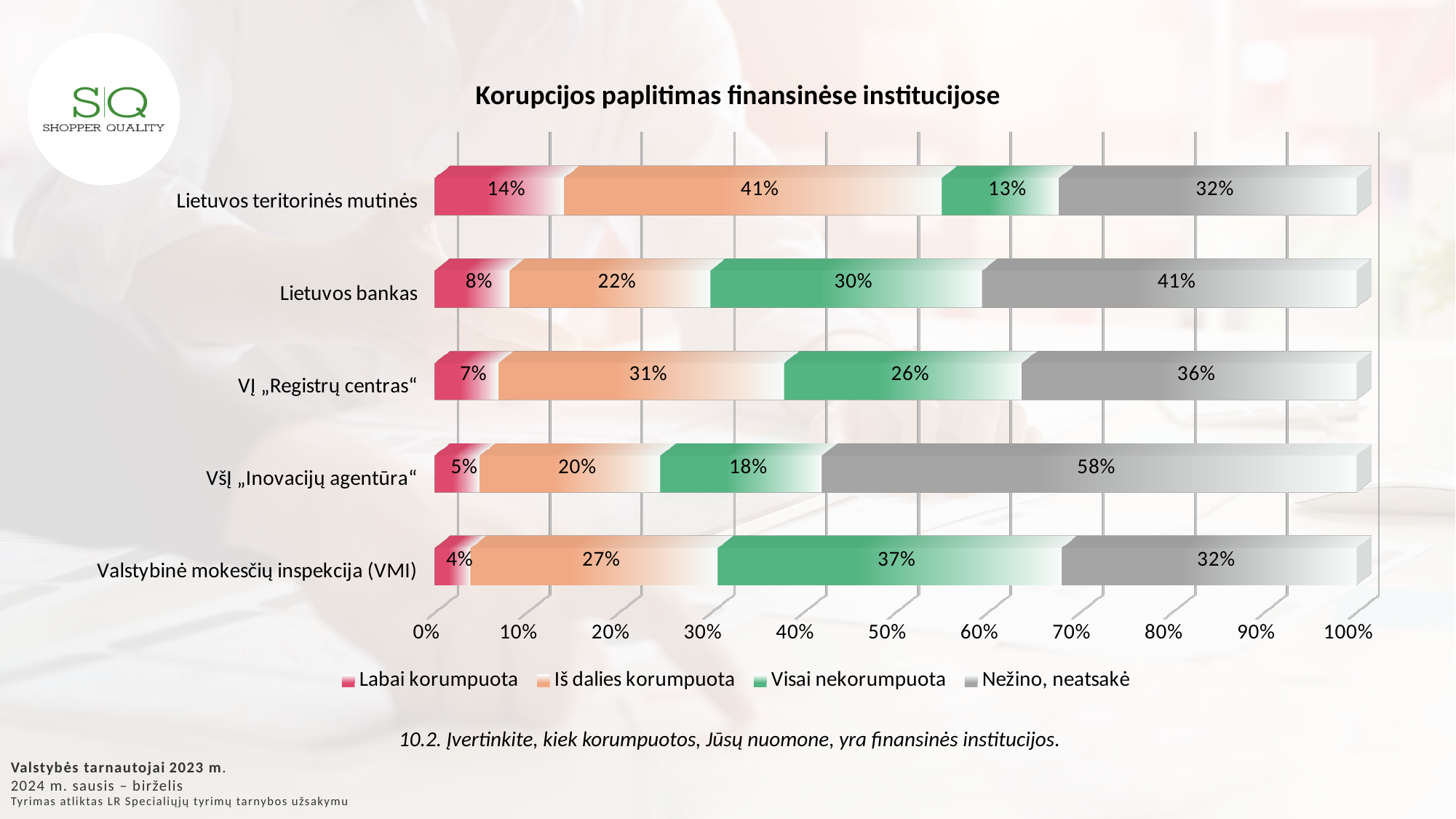
What is the title of the chart? Korupcijos paplitimas finansinėse institucijose What is the 'Visai nekorumpuota' value for Valstybinė mokesčių inspekcija (VMI)? 37% What is the 'Labai korumpuota' value for Lietuvos teritorinės mutinės? 14% What is the difference between the 'Iš dalies korumpuota' values for Lietuvos teritorinės mutinės and Lietuvos bankas? 19% Which institution has the highest 'Labai korumpuota' value? Lietuvos teritorinės mutinės How many series does the legend list? 4 What kind of chart is shown on the slide? Stacked bar chart How many institutions (categories) are shown in the chart? 5 What is the combined total of 'Labai korumpuota' and 'Iš dalies korumpuota' for VĮ „Registrų centras“? 38% What is the 'Nežino, neatsakė' value for VšĮ „Inovacijų agentūra“? 58% Which institution has the lowest 'Visai nekorumpuota' value? Lietuvos teritorinės mutinės Which is larger: the 'Nežino, neatsakė' value for Lietuvos bankas or for VĮ „Registrų centras“? Lietuvos bankas